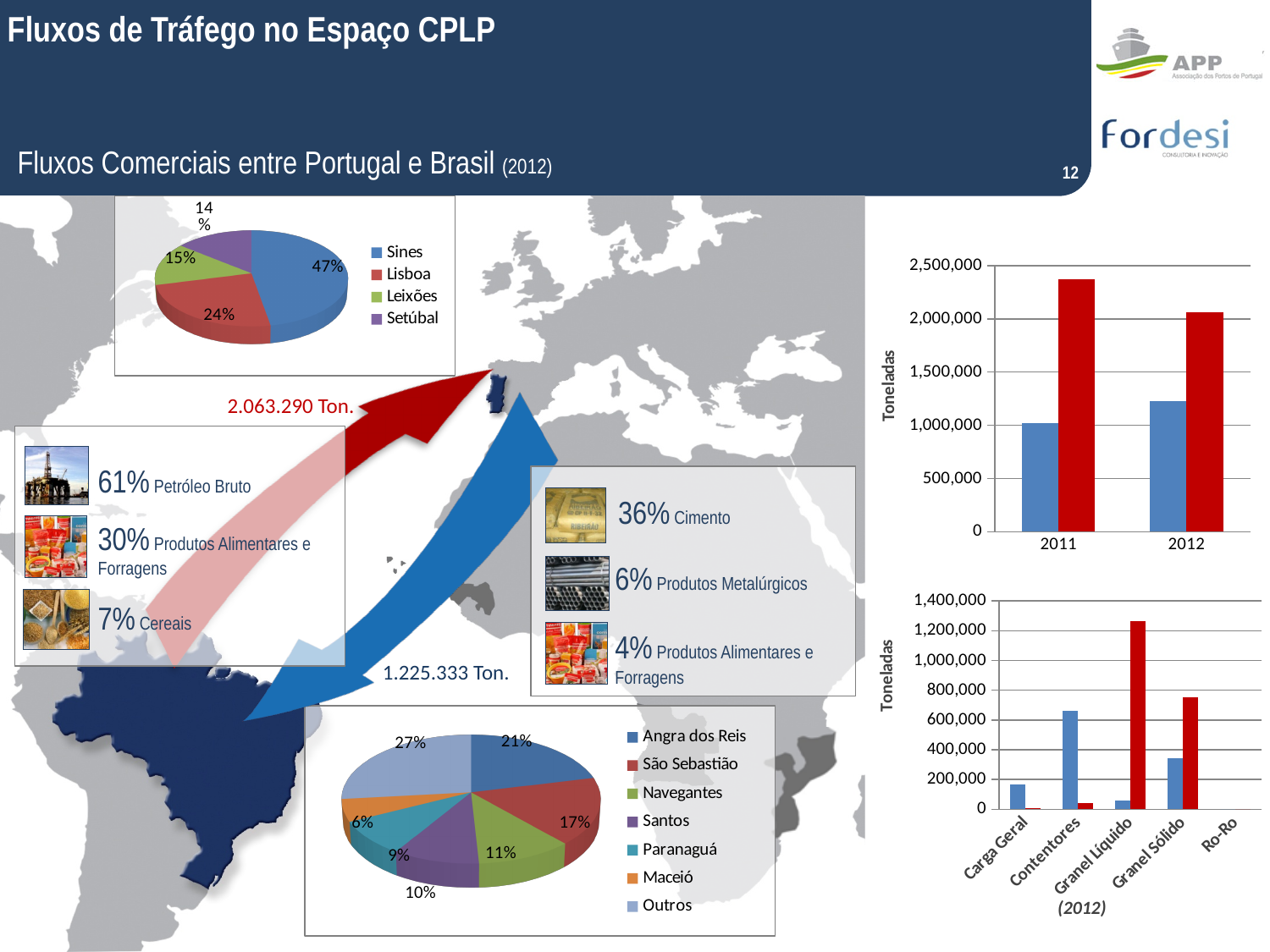
In the top-right bar chart, is the value of the red bar for 2011 greater or less than 2,000,000? greater In the top-left pie chart, what is the difference between the shares of Sines and Lisboa? 23% How many categories are shown on the x axis of the bottom-right bar chart? 5 In the bottom pie chart, what share does Angra dos Reis have? 21% In the bottom pie chart, which is larger: the share of São Sebastião or the share of Navegantes? São Sebastião In the bottom-right bar chart, is the value of the blue bar for Carga Geral greater or less than 200,000? less How many slices does the bottom pie chart have? 7 In the top-left pie chart, which port has the largest share? Sines In the top-left pie chart, what share does Sines have? 47% What kind of chart is the top-right chart with the years 2011 and 2012? Bar chart In the bottom pie chart, which named port (excluding Outros) has the smallest share? Maceió How many entries does the legend of the top-left pie chart list? 4